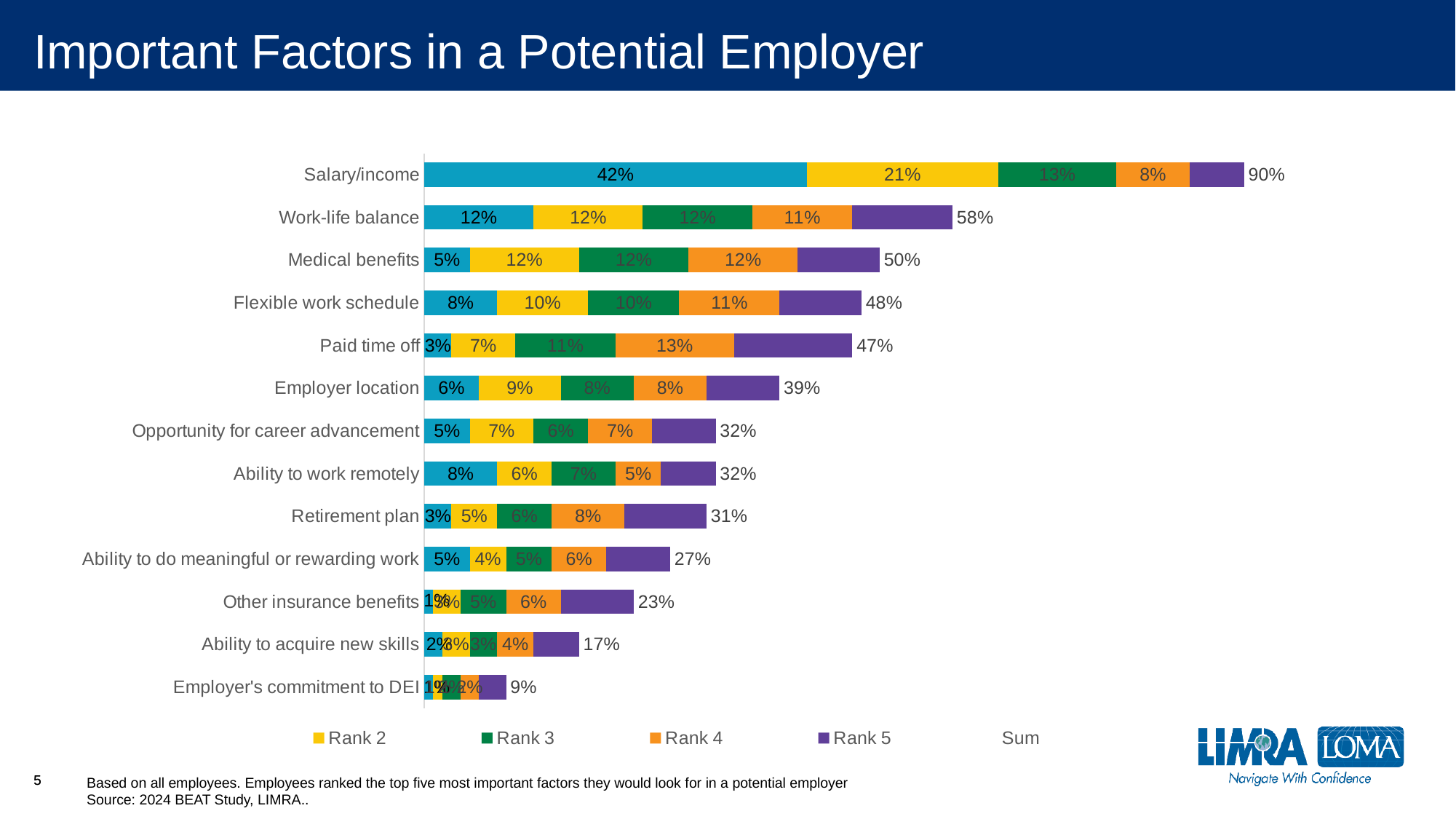
Which factor has the lowest Sum value? Employer's commitment to DEI What is the Rank 2 value for Salary/income? 21% How many factors are listed in the chart? 13 What is the Sum value for Ability to acquire new skills? 17% How many entries does the legend list? 5 What is the difference between the Sum values for Work-life balance and Medical benefits? 8% Which has a larger Sum value, Employer location or Retirement plan? Employer location What is the Rank 4 value for Paid time off? 13% What is the Rank 3 value for Work-life balance? 12% What kind of chart is shown on the slide? Stacked bar chart What is the Sum value for Salary/income? 90% Which factor has the highest Sum value? Salary/income